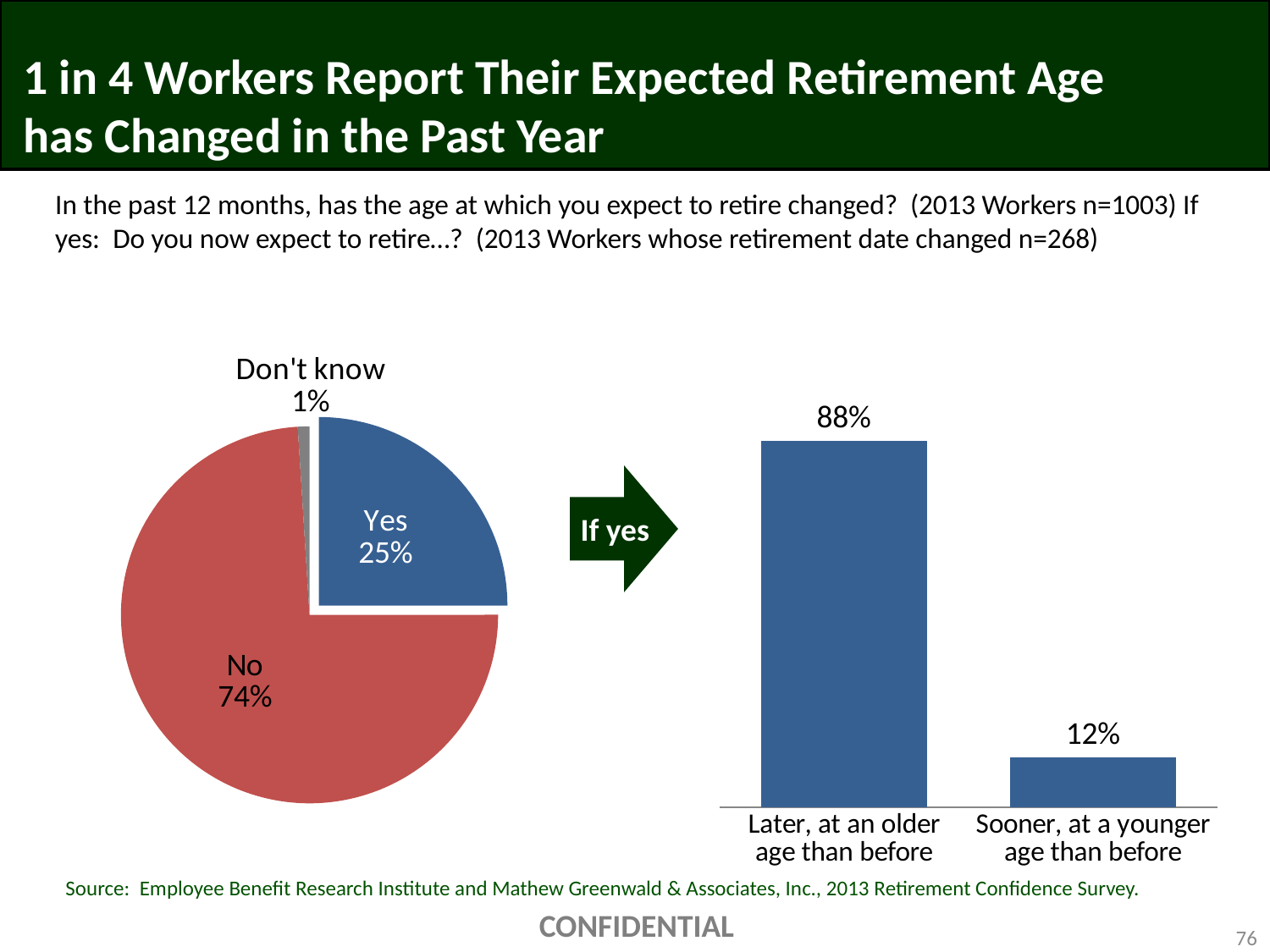
In the pie chart on the left, what share of workers answered "Don't know"? 1% In the pie chart on the left, which response has the largest slice? No In the pie chart on the left, what is the difference in percentage points between the "No" and "Yes" slices? 49 percentage points In the pie chart on the left, what share of workers answered "Yes"? 25% In the pie chart on the left, how many slices are there? 3 In the pie chart on the left, which response has the smallest slice? Don't know In the bar chart on the right, which category has the higher value? Later, at an older age than before In the bar chart on the right, what is the difference between the two bars in percentage points? 76 percentage points In the bar chart on the right, what is the value for "Later, at an older age than before"? 88% What type of chart is shown on the right side of the slide? Bar chart In the bar chart on the right, what is the value for "Sooner, at a younger age than before"? 12% In the pie chart on the left, what share of workers answered "No"? 74%